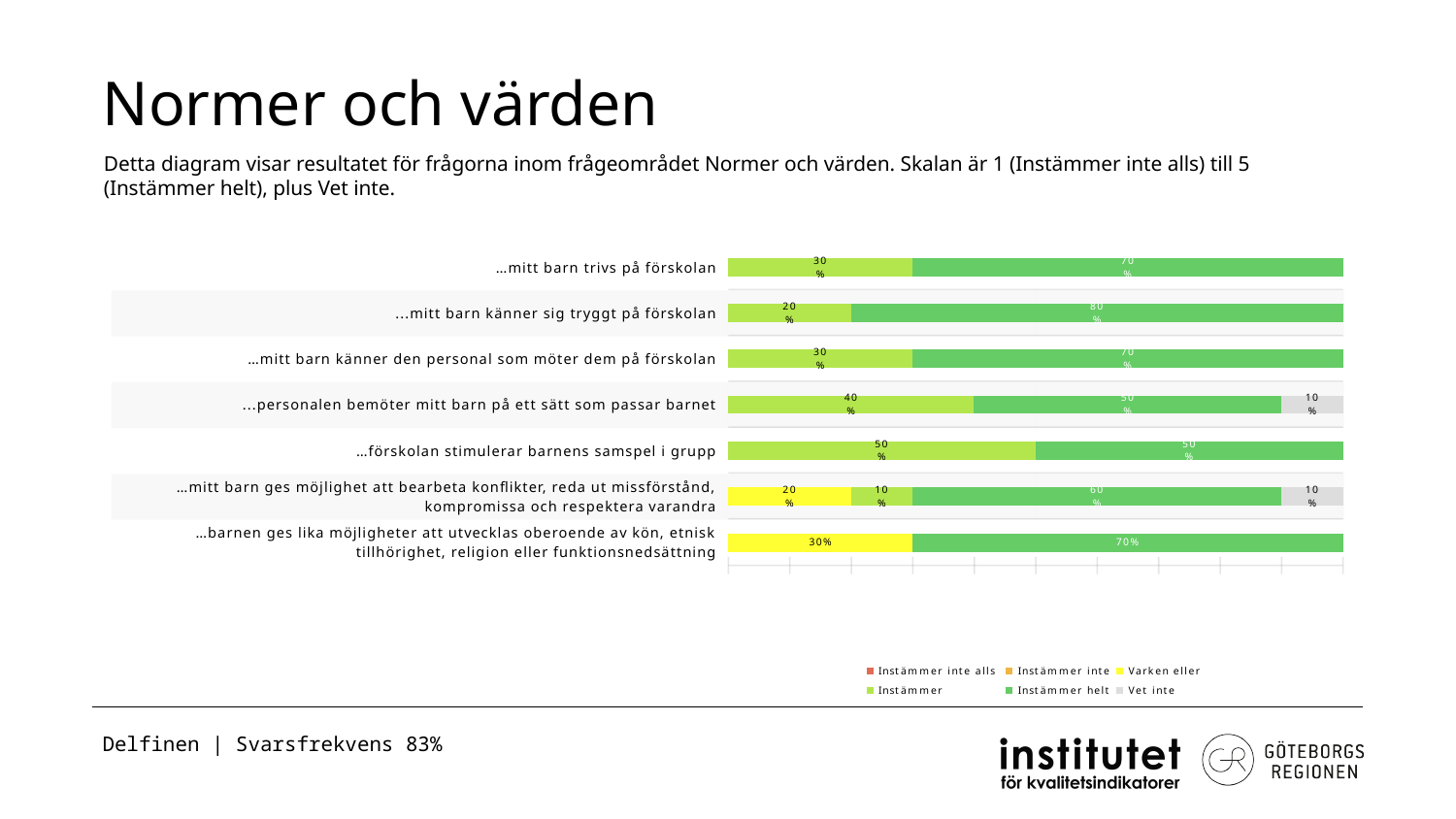
What is the 'Instämmer' value for '…förskolan stimulerar barnens samspel i grupp'? 50% How many series does the legend list? 6 What kind of chart is shown on the slide? Stacked bar chart What is the 'Instämmer helt' value for '…mitt barn ges möjlighet att bearbeta konflikter, reda ut missförstånd, kompromissa och respektera varandra'? 60% What is the 'Varken eller' value for '…barnen ges lika möjligheter att utvecklas oberoende av kön, etnisk tillhörighet, religion eller funktionsnedsättning'? 30% For '…mitt barn trivs på förskolan', what is the difference between the 'Instämmer helt' value and the 'Instämmer' value? 40 percentage points Which has the larger 'Instämmer helt' value: '…mitt barn trivs på förskolan' or '…personalen bemöter mitt barn på ett sätt som passar barnet'? …mitt barn trivs på förskolan Which statement has the highest 'Instämmer helt' value? …mitt barn känner sig tryggt på förskolan What is the title of the slide containing the chart? Normer och värden What is the 'Instämmer helt' value for '…mitt barn känner sig tryggt på förskolan'? 80% What is the 'Vet inte' value for '…personalen bemöter mitt barn på ett sätt som passar barnet'? 10% How many statements (categories) are plotted in the chart? 7